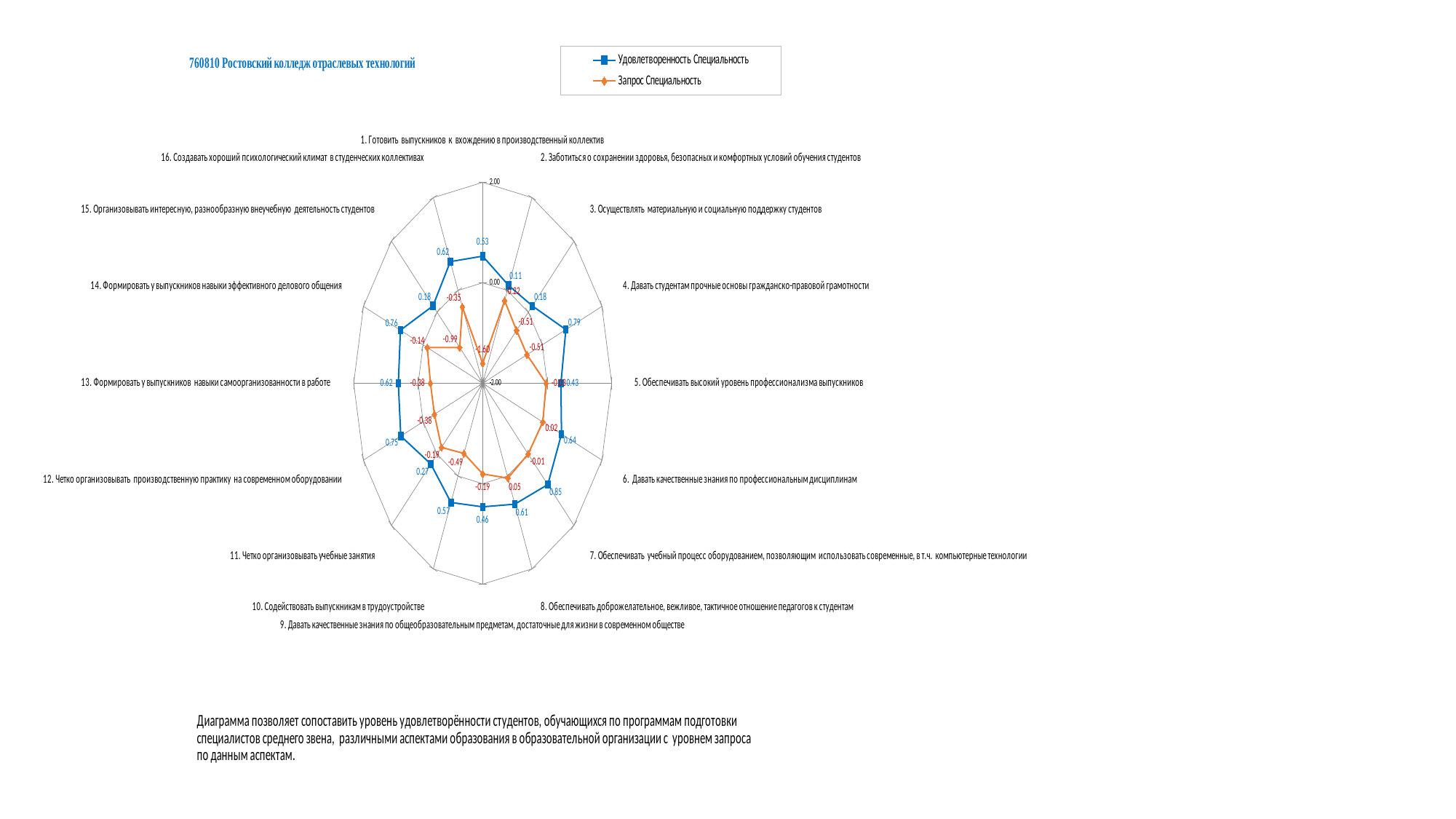
What is the title shown above the chart? 760810 Ростовский колледж отраслевых технологий How many series does the legend list? 2 For which aspect is the Запрос Специальность value the lowest? 1. Готовить выпускников к вхождению в производственный коллектив What is the value of the Удовлетворенность Специальность series for aspect 4 (Давать студентам прочные основы гражданско-правовой грамотности)? 0.79 Which is larger for aspect 14 (Формировать у выпускников навыки эффективного делового общения): the Удовлетворенность Специальность value or the Запрос Специальность value? Удовлетворенность Специальность What kind of chart is shown on the slide? radar chart For which aspect is the Удовлетворенность Специальность value the lowest? 2. Заботиться о сохранении здоровья, безопасных и комфортных условий обучения студентов What is the difference between the Удовлетворенность Специальность values for aspect 7 (0.85) and aspect 11 (0.27)? 0.58 What is the value of the Удовлетворенность Специальность series for aspect 7 (Обеспечивать учебный процесс оборудованием...)? 0.85 How many categories (aspects) are plotted on the radar chart? 16 For which aspect is the Удовлетворенность Специальность value the highest? 7. Обеспечивать учебный процесс оборудованием, позволяющим использовать современные, в т.ч. компьютерные технологии What is the value of the Запрос Специальность series for aspect 15 (Организовывать интересную, разнообразную внеучебную деятельность студентов)? -0.99